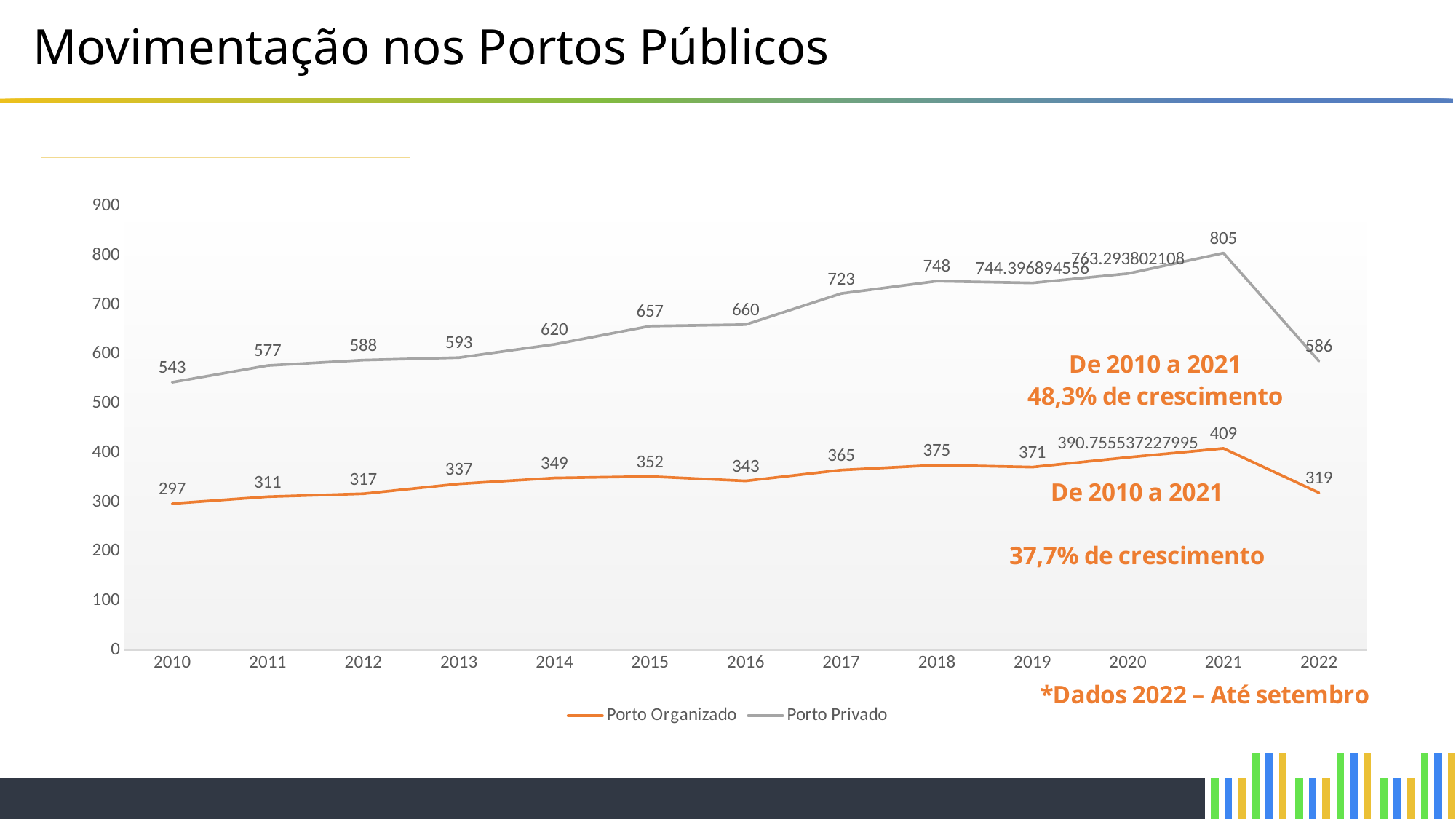
What kind of chart is shown on the slide? Line chart What is the value for Porto Privado in 2021? 805 How many years are shown on the x axis? 13 Which is larger in 2017: Porto Privado or Porto Organizado? Porto Privado How many series does the legend list? 2 What is the difference between Porto Privado and Porto Organizado in 2021? 396 What is the value for Porto Organizado in 2010? 297 Is the value for Porto Privado in 2022 greater or less than 500? greater In which year does the Porto Organizado series have its lowest value? 2010 In which year does the Porto Privado series reach its highest value? 2021 What is the value for Porto Organizado in 2022? 319 What is the value for Porto Privado in 2015? 657